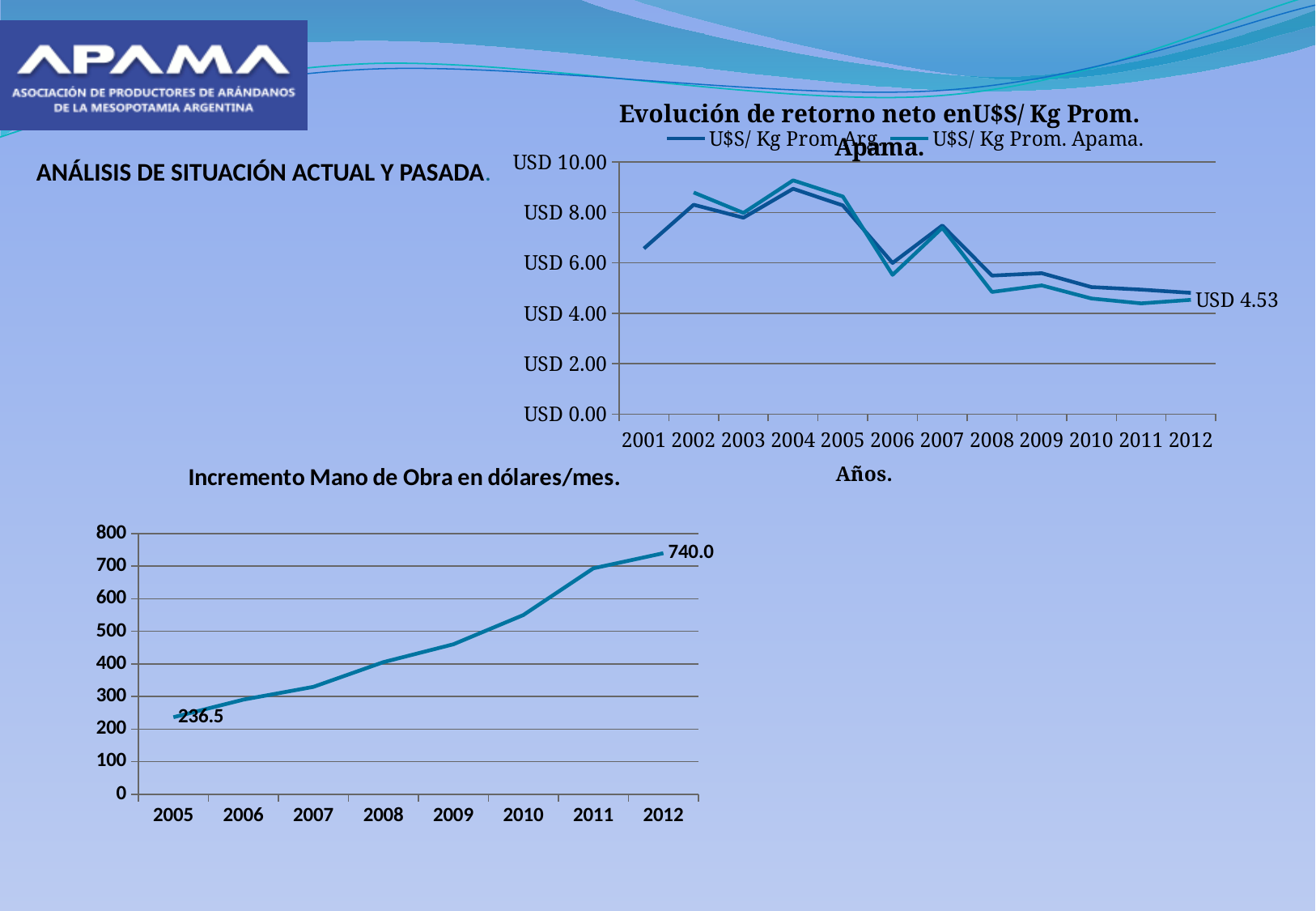
In the chart titled 'Evolución de retorno neto en U$S/Kg Prom. Apama.', what is the label of the x axis? Años. In the chart titled 'Incremento Mano de Obra en dólares/mes.', how many years are shown on the x axis? 8 In the chart titled 'Evolución de retorno neto en U$S/Kg Prom. Apama.', is the value for U$S/Kg Prom. Apama. in 2004 greater or less than USD 8.00? greater In the chart titled 'Evolución de retorno neto en U$S/Kg Prom. Apama.', what data label is printed at the 2012 end of the lines? USD 4.53 In the chart titled 'Incremento Mano de Obra en dólares/mes.', what is the difference between the 2012 value and the 2005 value? 503.5 What kind of chart is the 'Incremento Mano de Obra en dólares/mes.' chart? line chart In the chart titled 'Evolución de retorno neto en U$S/Kg Prom. Apama.', how many years are shown on the x axis? 12 In the chart titled 'Evolución de retorno neto en U$S/Kg Prom. Apama.', is the value for U$S/Kg Prom Arg. in 2001 greater or less than USD 8.00? less In the chart titled 'Incremento Mano de Obra en dólares/mes.', what is the value for 2005? 236.5 In the chart titled 'Incremento Mano de Obra en dólares/mes.', what is the value for 2012? 740.0 In the chart titled 'Incremento Mano de Obra en dólares/mes.', do the values rise or fall from 2005 to 2012? rise In the chart titled 'Evolución de retorno neto en U$S/Kg Prom. Apama.', how many series does the legend list? 2